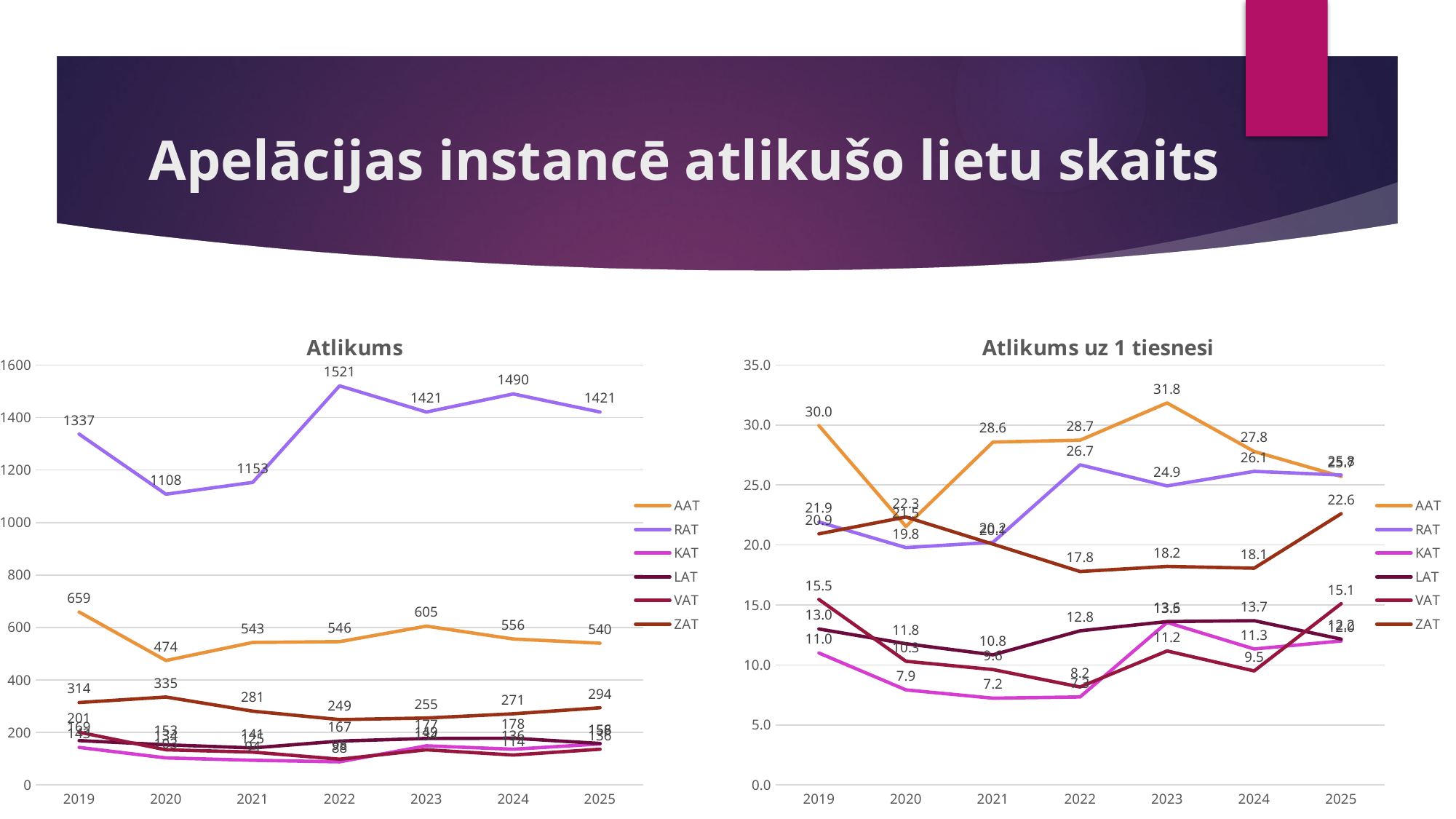
In the 'Atlikums' chart, what is the ZAT value for 2020? 335 How many series does the legend of the 'Atlikums uz 1 tiesnesi' chart list? 6 In the 'Atlikums' chart, which series has the highest value in 2025? RAT In the 'Atlikums' chart, in which year does RAT reach its highest value? 2022 In the 'Atlikums uz 1 tiesnesi' chart, what is the RAT value for 2022? 26.7 What kind of chart is the 'Atlikums' chart? line chart In the 'Atlikums' chart, what is the RAT value for 2022? 1521 In the 'Atlikums uz 1 tiesnesi' chart, what is the ZAT value for 2025? 22.6 In the 'Atlikums uz 1 tiesnesi' chart, what is the AAT value for 2023? 31.8 In the 'Atlikums uz 1 tiesnesi' chart, is the ZAT value for 2022 greater or less than 20.0? less In the 'Atlikums' chart, what is the AAT value for 2023? 605 In the 'Atlikums' chart, what is the difference between the RAT values for 2022 and 2019? 184